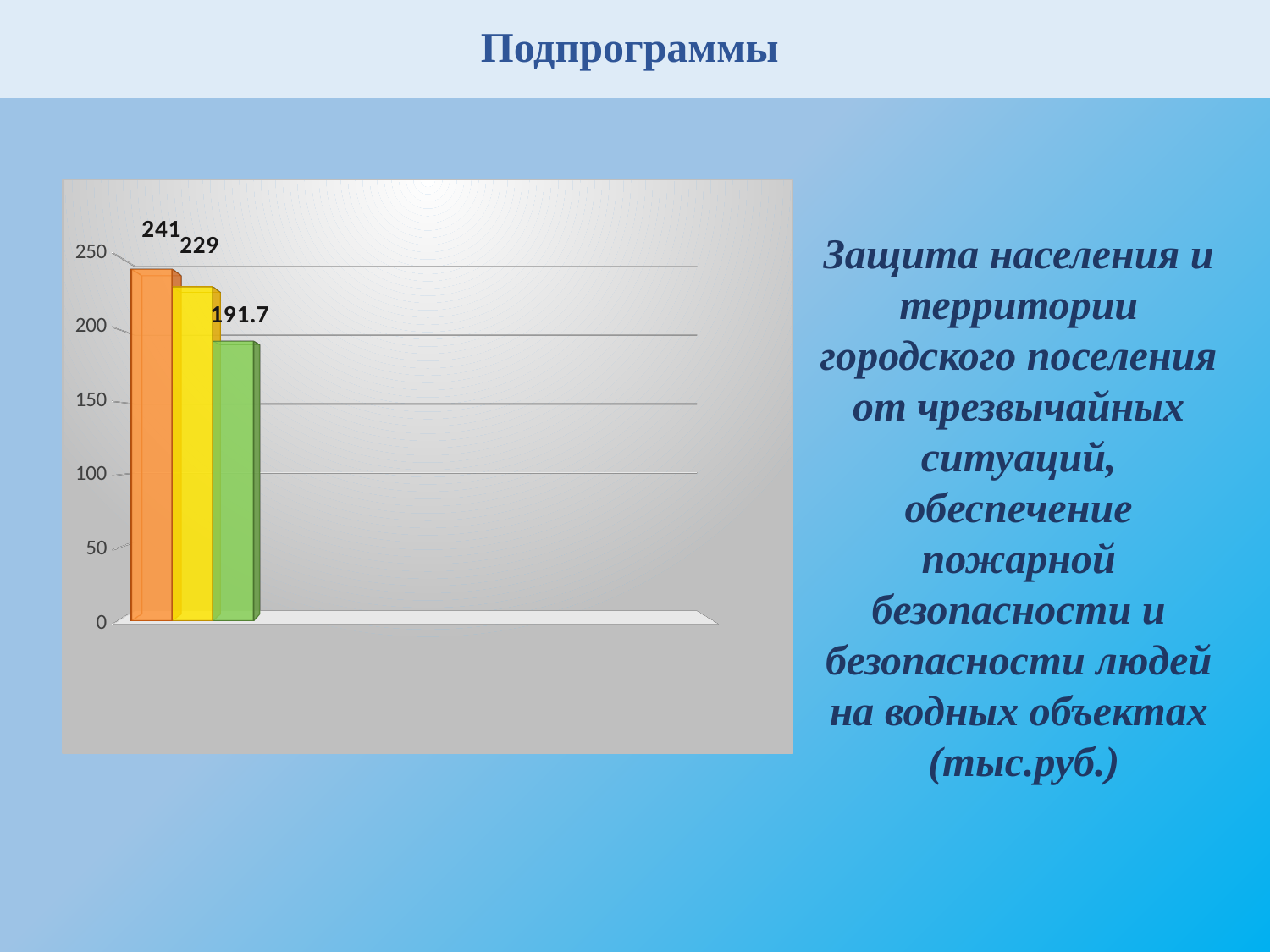
What is the difference between the yellow bar and the green bar? 37.3 What is the difference between the orange bar and the yellow bar? 12 Which is larger, the value of the orange bar or the green bar? The orange bar How many bars are plotted in the chart? 3 What kind of chart is shown on the slide? Bar chart Which bar has the lowest value? The green bar (191.7) What value is shown on the green bar? 191.7 What value is shown on the orange bar? 241 Is the value of the green bar greater or less than 200? less What value is shown on the yellow bar? 229 Do the bar values rise or fall from left to right? Fall Which bar has the highest value? The orange bar (241)